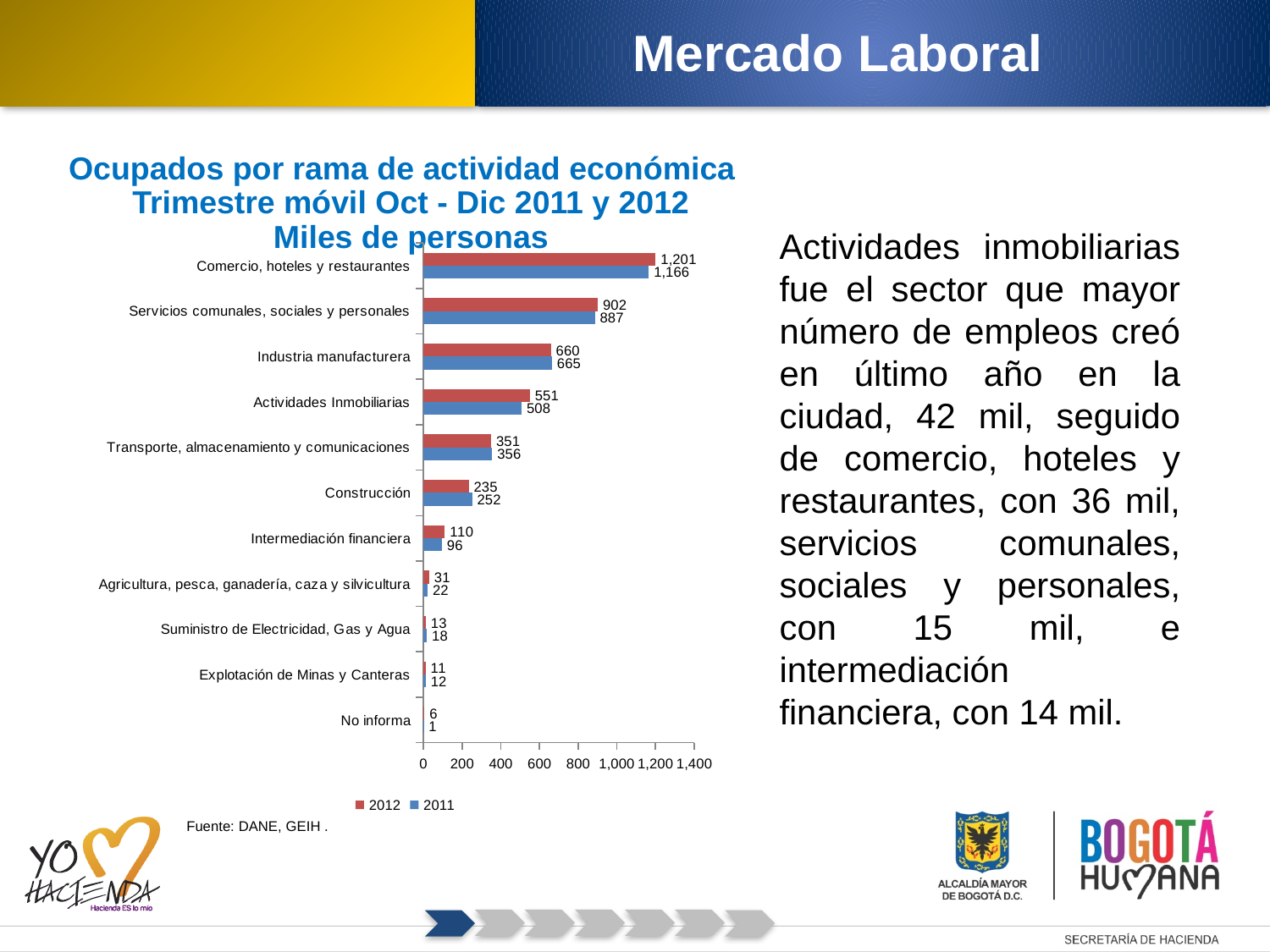
What source is cited below the chart? DANE, GEIH What is the 2012 value for Intermediación financiera? 110 What is the 2011 value for Actividades Inmobiliarias? 508 Is the 2012 value for Construcción greater or less than 200? greater How many categories are shown on the chart? 11 How many series does the legend list? 2 What is the 2012 value for Comercio, hoteles y restaurantes? 1,201 What is the difference between the 2012 and 2011 values for Actividades Inmobiliarias? 43 Which category has the highest 2012 value? Comercio, hoteles y restaurantes Which is larger for Industria manufacturera, the 2012 value or the 2011 value? 2011 Which category has the lowest 2011 value? No informa What kind of chart is shown on the slide? bar chart